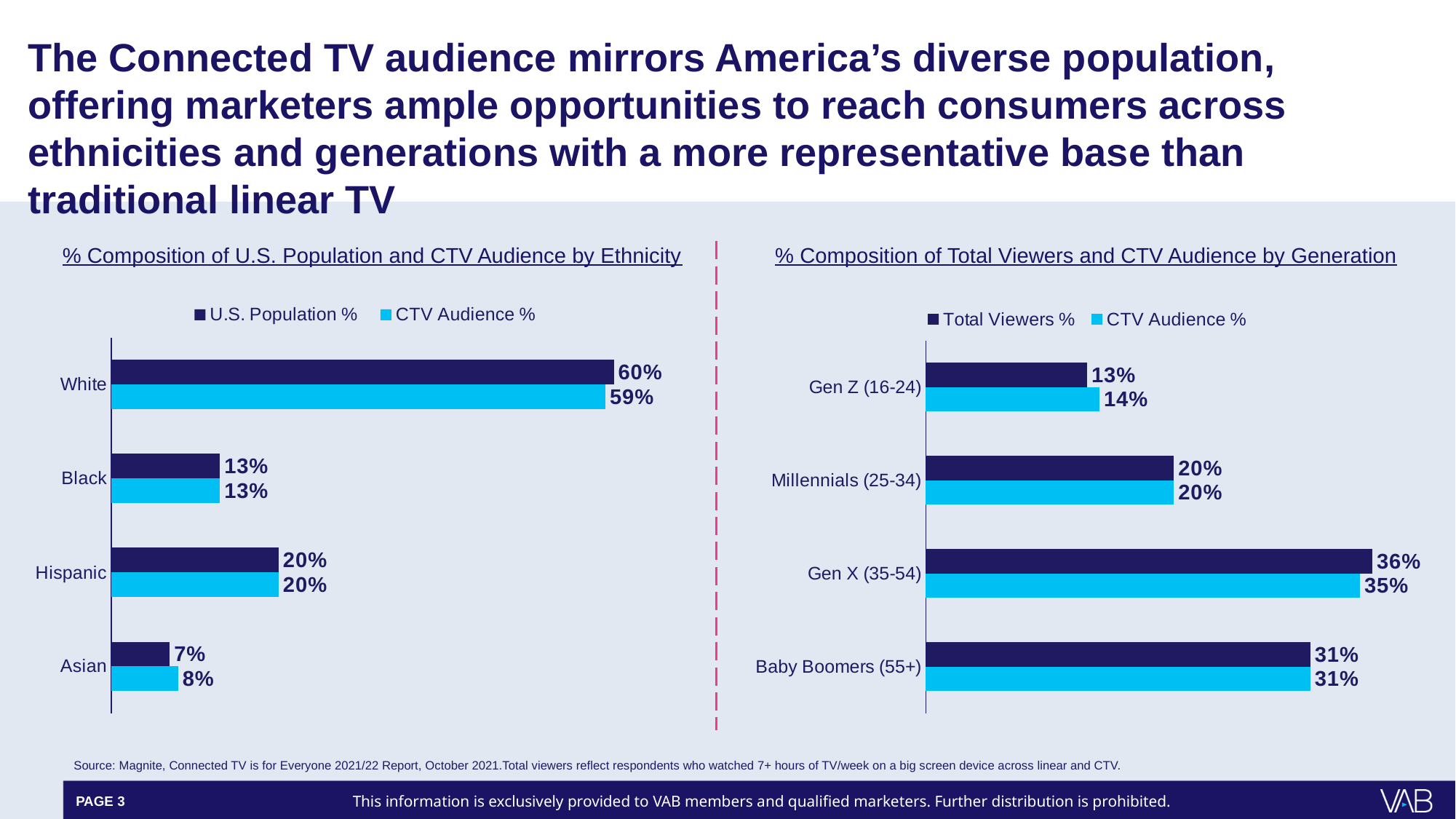
What type of chart is the generation chart on the right? Bar chart In the ethnicity chart on the left, what is the U.S. Population % for White? 60% In the ethnicity chart on the left, what is the difference between the U.S. Population % and the CTV Audience % for White? 1% In the ethnicity chart on the left, how many ethnicity categories are shown? 4 In the generation chart on the right, what is the CTV Audience % for Gen Z (16-24)? 14% In the ethnicity chart on the left, which ethnicity has the lowest U.S. Population %? Asian In the generation chart on the right, which is larger: the CTV Audience % for Gen X (35-54) or for Baby Boomers (55+)? Gen X (35-54) In the ethnicity chart on the left, what is the CTV Audience % for Asian? 8% In the generation chart on the right, which generation has the lowest Total Viewers %? Gen Z (16-24) In the generation chart on the right, what is the Total Viewers % for Gen X (35-54)? 36% In the generation chart on the right, how many series does the legend list? 2 In the ethnicity chart on the left, which ethnicity has the highest CTV Audience %? White